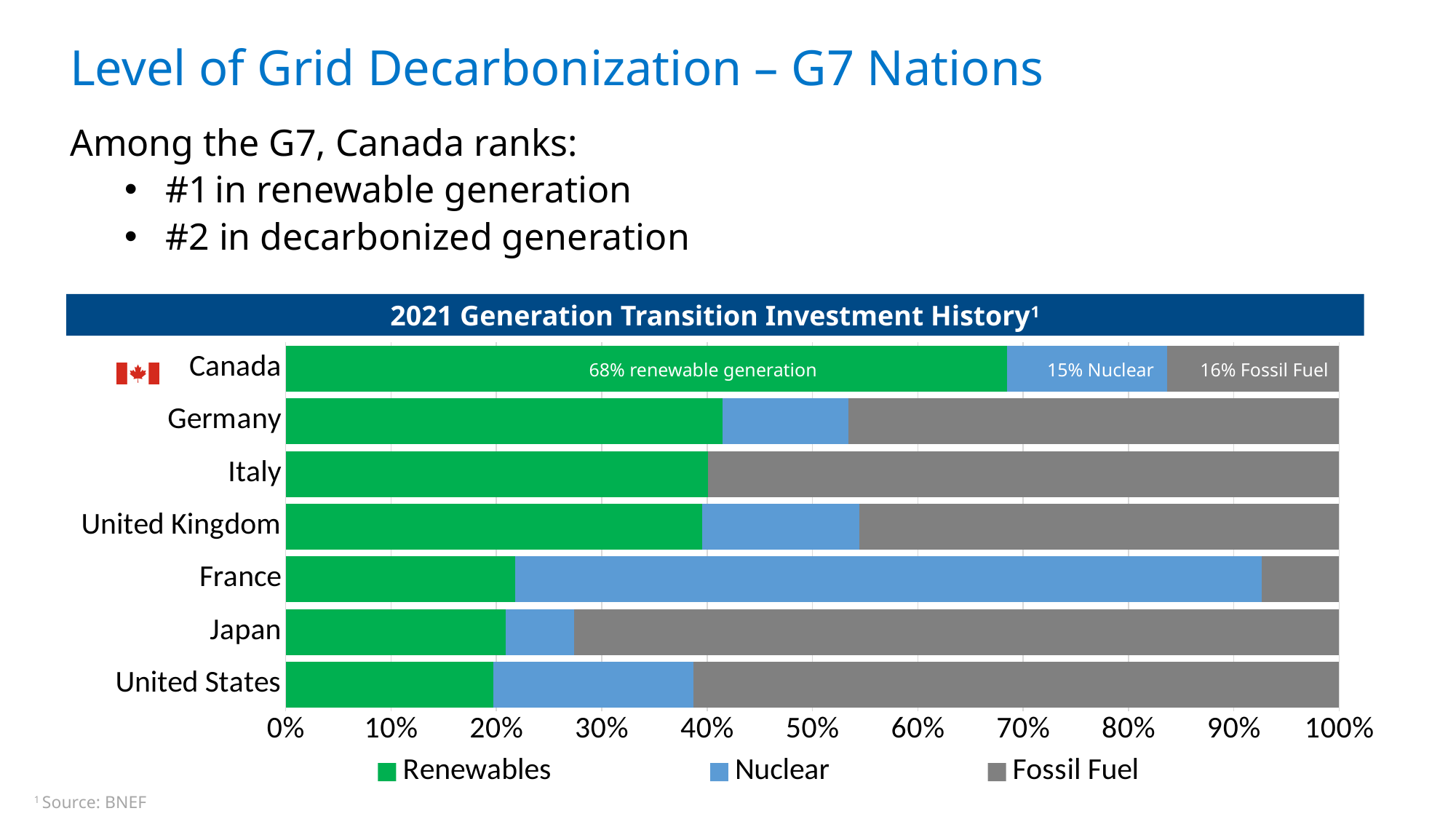
What is the Nuclear share shown for Canada? 15% How many countries are shown in the chart? 7 Which country has the smallest Fossil Fuel segment? France What share of Canada's generation is labelled as renewable generation? 68% How many series does the legend list? 3 Which country has the largest Fossil Fuel segment? Japan Which country has the largest Renewables segment? Canada Which is larger, the Nuclear segment for France or for Germany? France Is the Renewables share for Germany greater or less than 50%? less What is the Fossil Fuel share shown for Canada? 16% Which country has the largest Nuclear segment? France Is the Renewables share for the United States greater or less than 30%? less